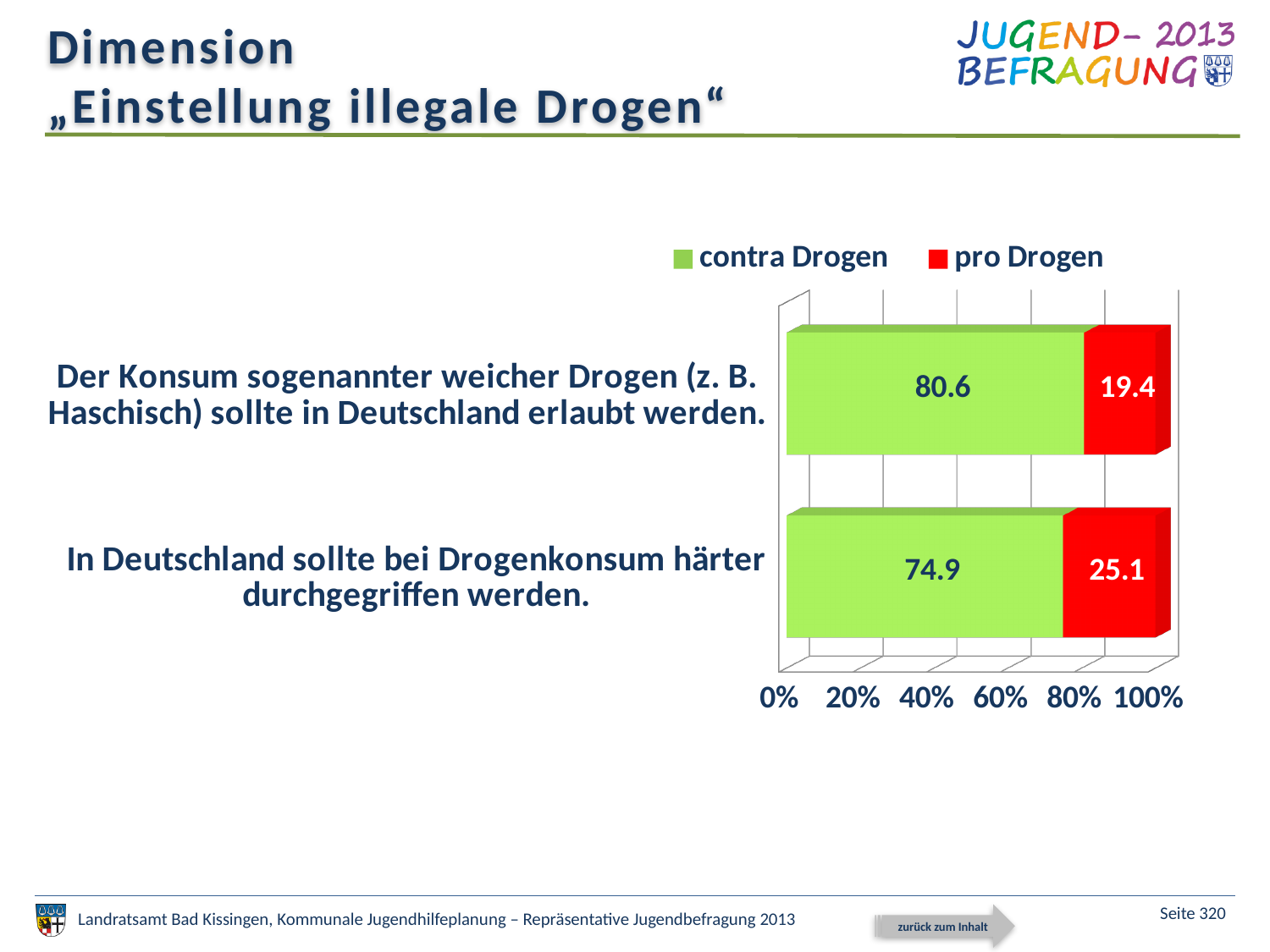
What is the difference between the 'pro Drogen' values of the two statements? 5.7 Which statement has the lower 'pro Drogen' value? Der Konsum sogenannter weicher Drogen (z. B. Haschisch) sollte in Deutschland erlaubt werden. How many series does the legend list? 2 What is the 'contra Drogen' value for the statement 'In Deutschland sollte bei Drogenkonsum härter durchgegriffen werden.'? 74.9 Is the 'pro Drogen' value for 'In Deutschland sollte bei Drogenkonsum härter durchgegriffen werden.' larger or smaller than the 'pro Drogen' value for the statement about weiche Drogen? larger What is the 'pro Drogen' value for the statement 'In Deutschland sollte bei Drogenkonsum härter durchgegriffen werden.'? 25.1 What is the difference between the 'contra Drogen' values of the two statements? 5.7 What is the 'pro Drogen' value for the statement 'Der Konsum sogenannter weicher Drogen (z. B. Haschisch) sollte in Deutschland erlaubt werden.'? 19.4 What kind of chart is shown on the slide? Stacked bar chart How many statements (categories) are shown in the chart? 2 What is the 'contra Drogen' value for the statement 'Der Konsum sogenannter weicher Drogen (z. B. Haschisch) sollte in Deutschland erlaubt werden.'? 80.6 Which statement has the higher 'contra Drogen' value? Der Konsum sogenannter weicher Drogen (z. B. Haschisch) sollte in Deutschland erlaubt werden.